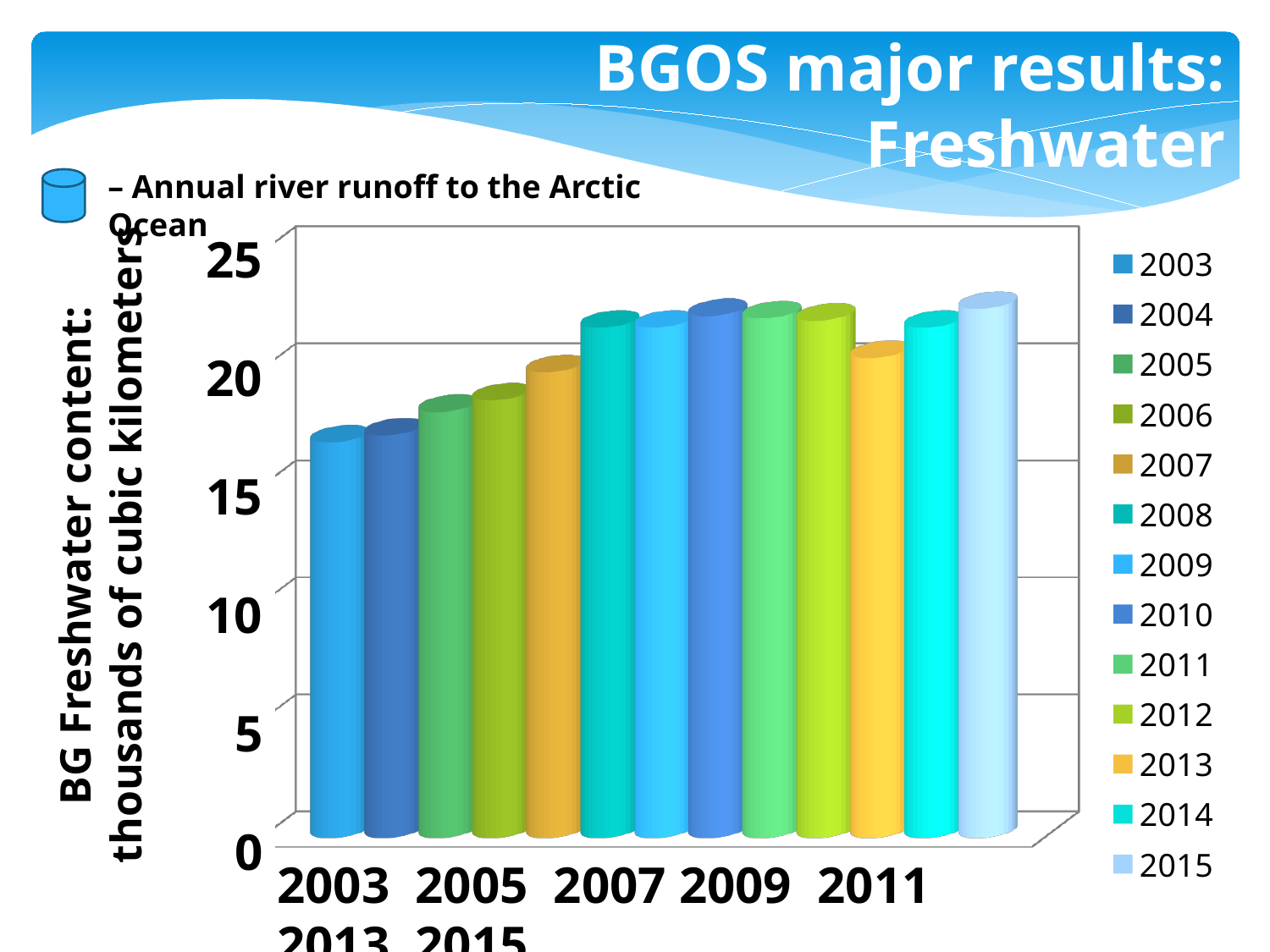
Do the values generally rise or fall from 2003 to 2010? rise What is the title of the vertical axis of the chart? BG Freshwater content: thousands of cubic kilometers Is the value for 2005 greater or less than 20? less Is the value for 2003 greater or less than 20? less How many entries does the chart legend list? 13 Which is larger, the value for 2006 or the value for 2008? 2008 Which is larger, the value for 2003 or the value for 2010? 2010 Is the value for 2015 greater or less than 20? greater How many bars (years) are plotted in the chart? 13 What kind of chart is shown on the slide? bar chart